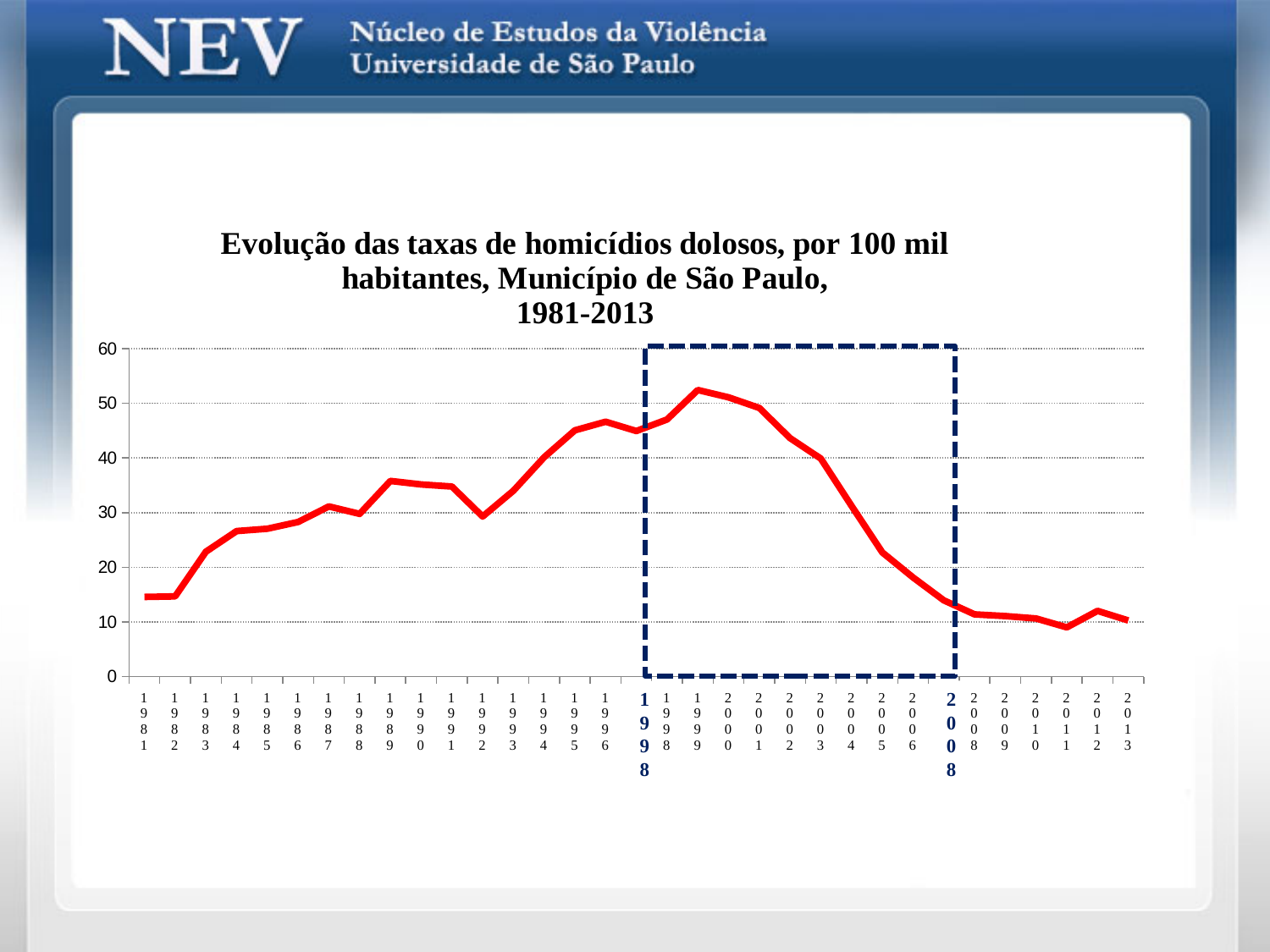
What is the title of the chart? Evolução das taxas de homicídios dolosos, por 100 mil habitantes, Município de São Paulo, 1981-2013 Is the value for 2006 greater or less than 20? less Which two years are marked by the dashed box on the chart? 1998 and 2008 In which year does the homicide rate reach its lowest point? 2011 In which year does the homicide rate reach its highest point? 1999 Which year has the higher homicide rate, 1999 or 2008? 1999 What kind of chart is shown on the slide? line chart Does the homicide rate rise or fall between 1999 and 2008? fall Is the value for 1999 greater or less than 50? greater Is the value for 1981 greater or less than 20? less How many years are plotted along the x axis of the chart? 33